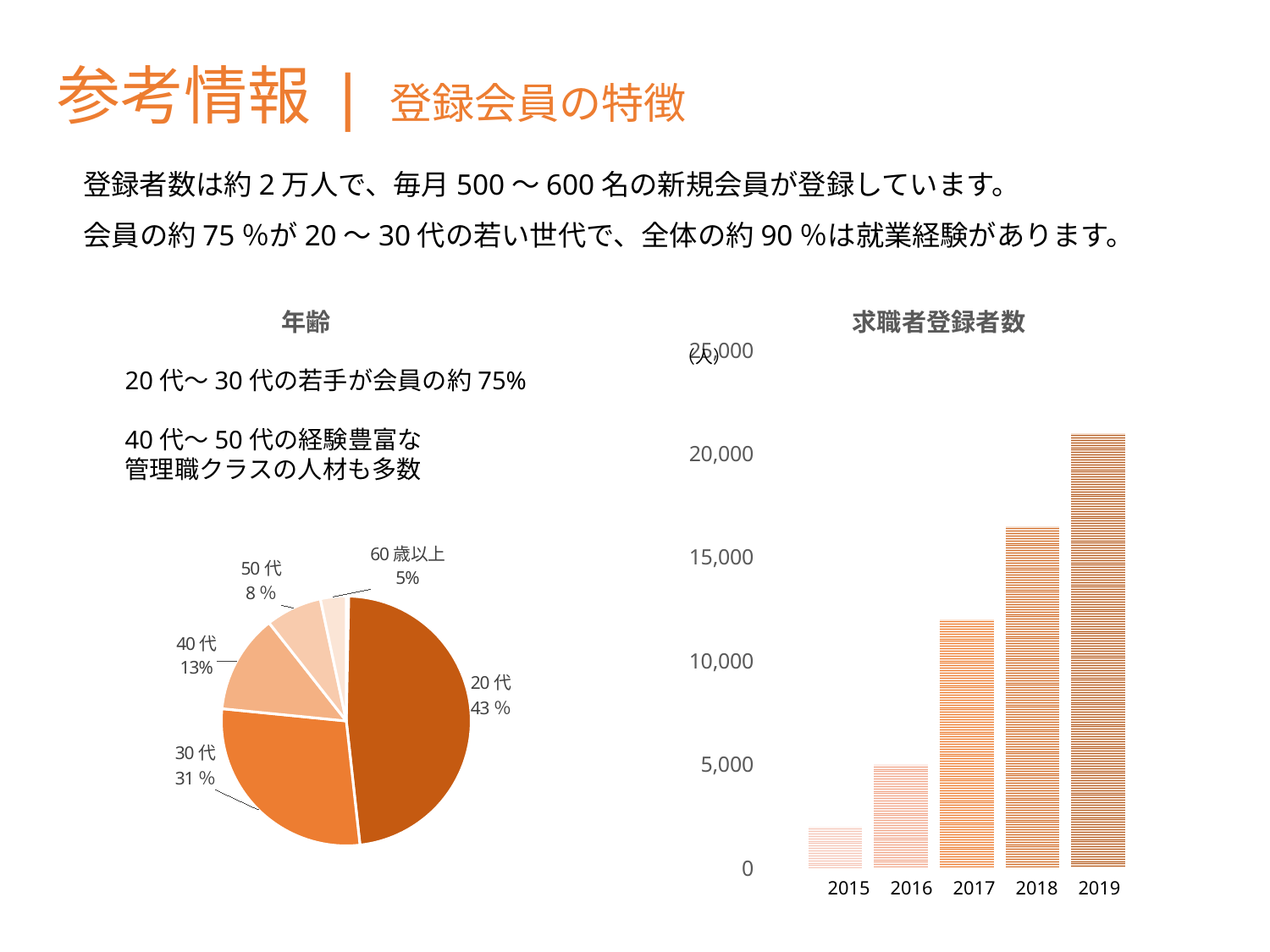
What kind of chart is the 求職者登録者数 chart on the right? bar chart How many years are shown on the x axis of the 求職者登録者数 chart? 5 In the 求職者登録者数 chart, is the value for 2019 greater or less than 20,000? greater What kind of chart is the 年齢 chart on the left? pie chart In the 年齢 pie chart, which is larger, the share for 50代 or the share for 40代? 40代 In the 年齢 pie chart, what share is shown for 40代? 13% In the 年齢 pie chart, what share is shown for 20代? 43 % In the 年齢 pie chart, which age group has the largest slice? 20代 How many slices does the 年齢 pie chart have? 5 In the 年齢 pie chart, what is the difference in percentage points between 20代 and 30代? 12 In the 求職者登録者数 chart, do the values rise or fall from 2015 to 2019? rise In the 年齢 pie chart, which age group has the smallest slice? 60歳以上